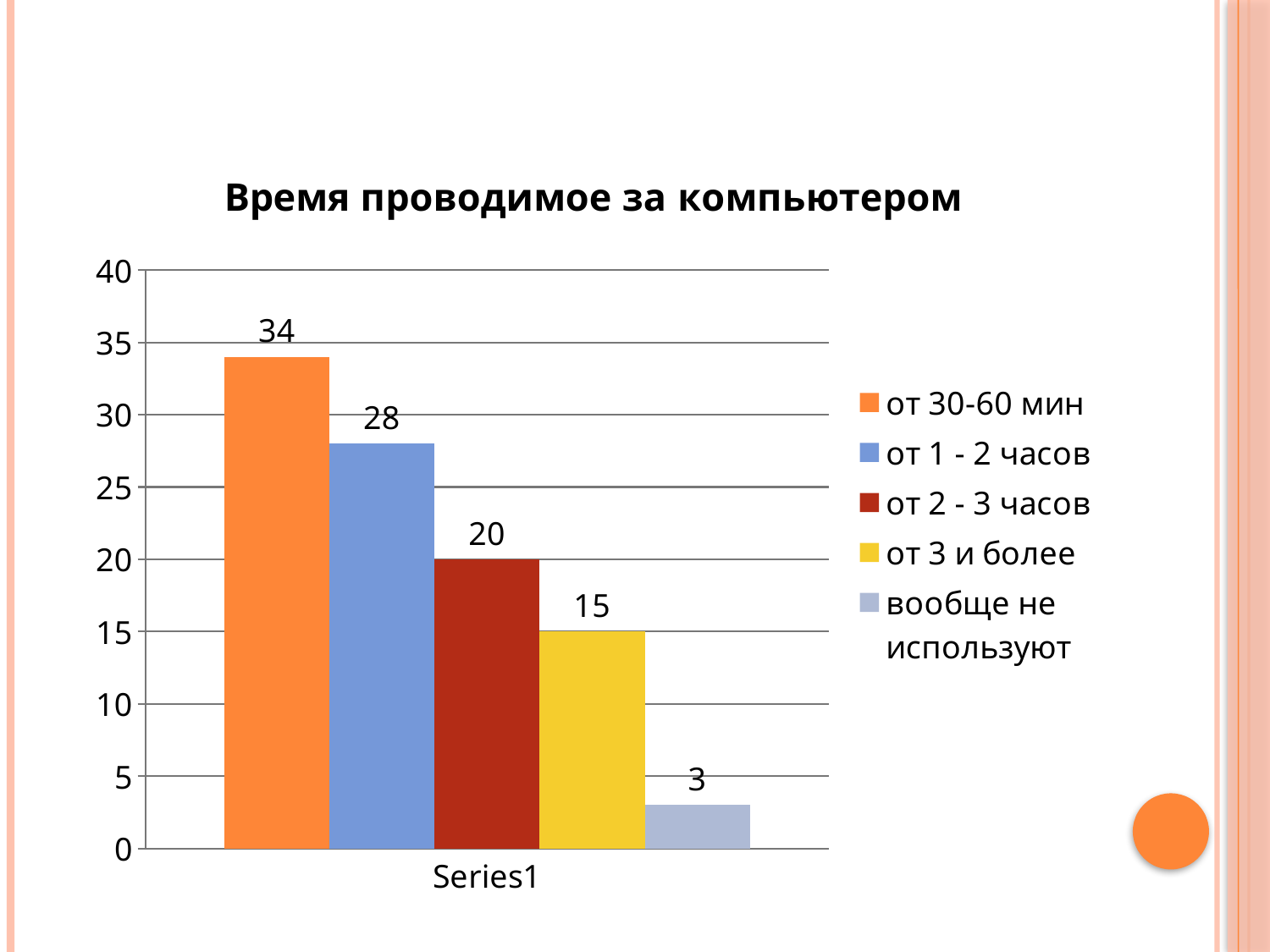
Which category has the lowest value? вообще не используют What is the value for "от 30-60 мин"? 34 What is the title of the chart? Время проводимое за компьютером What kind of chart is shown on the slide? bar chart Which category has the highest value? от 30-60 мин Is the value for "от 1 - 2 часов" greater or less than 25? greater How many series does the legend list? 5 What is the difference between the values for "от 30-60 мин" and "от 1 - 2 часов"? 6 Which is larger, the value for "от 2 - 3 часов" or the value for "от 3 и более"? от 2 - 3 часов What is the value for "от 1 - 2 часов"? 28 What is the value for "вообще не используют"? 3 What is the difference between the values for "от 2 - 3 часов" and "от 3 и более"? 5